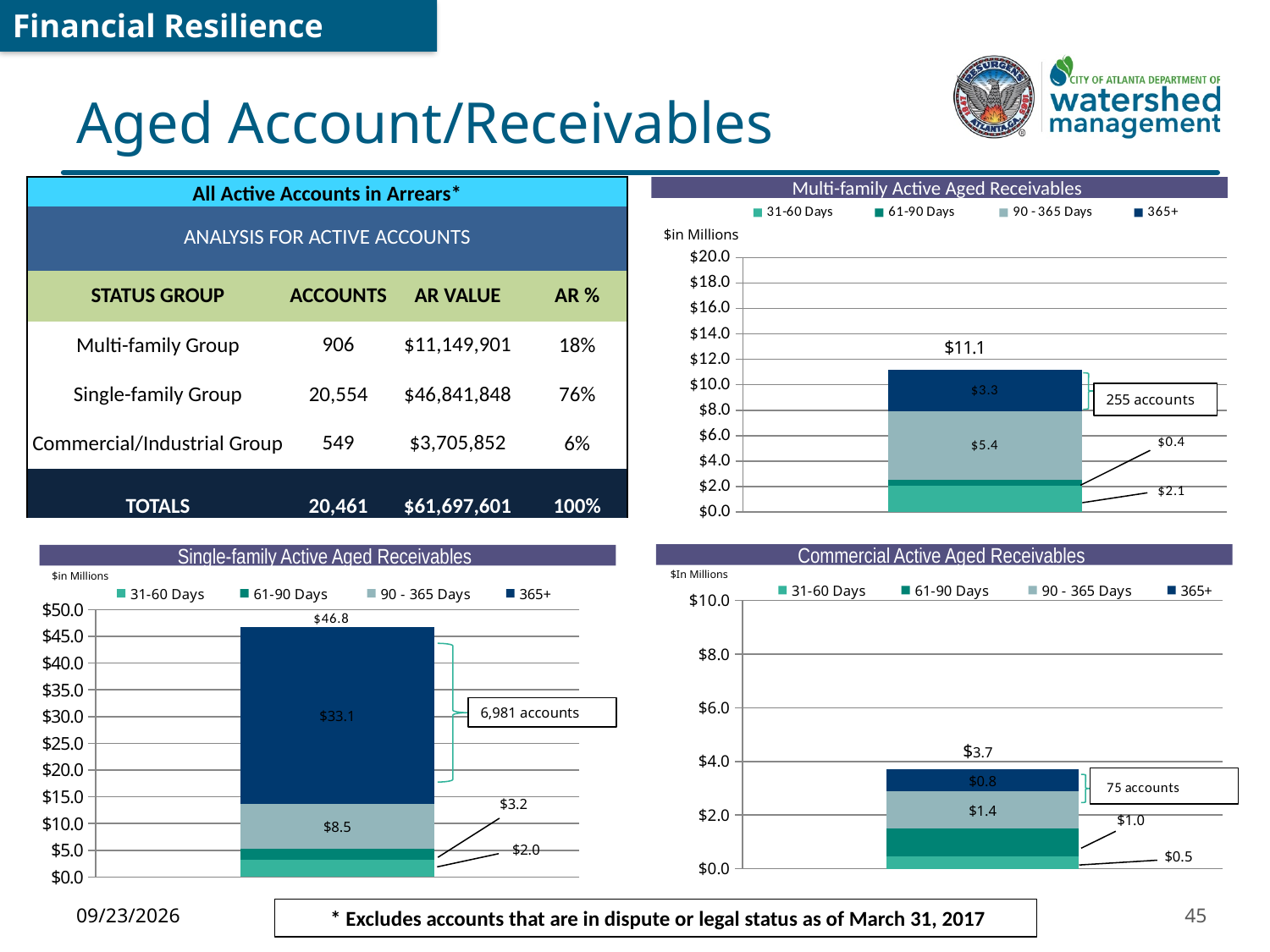
In the Single-family Active Aged Receivables chart, what is the difference between the 365+ segment and the 90 - 365 Days segment? $24.6 In the Single-family Active Aged Receivables chart, which aging bucket has the largest value? 365+ In the Multi-family Active Aged Receivables chart, what is the total value of the stacked bar? $11.1 In the Commercial Active Aged Receivables chart, what is the value of the 61-90 Days segment? $1.0 In the Multi-family Active Aged Receivables chart, which aging bucket has the smallest value? 61-90 Days What kind of chart is the Multi-family Active Aged Receivables chart? Stacked bar chart In the Single-family Active Aged Receivables chart, what is the total value of the stacked bar? $46.8 In the Commercial Active Aged Receivables chart, which is larger, the 90 - 365 Days segment or the 365+ segment? 90 - 365 Days In the Commercial Active Aged Receivables chart, how many accounts does the annotation attribute to the 365+ segment? 75 accounts In the Single-family Active Aged Receivables chart, what is the value of the 365+ segment? $33.1 In the Multi-family Active Aged Receivables chart, what is the value of the 90 - 365 Days segment? $5.4 How many series does the legend of the Commercial Active Aged Receivables chart list? 4